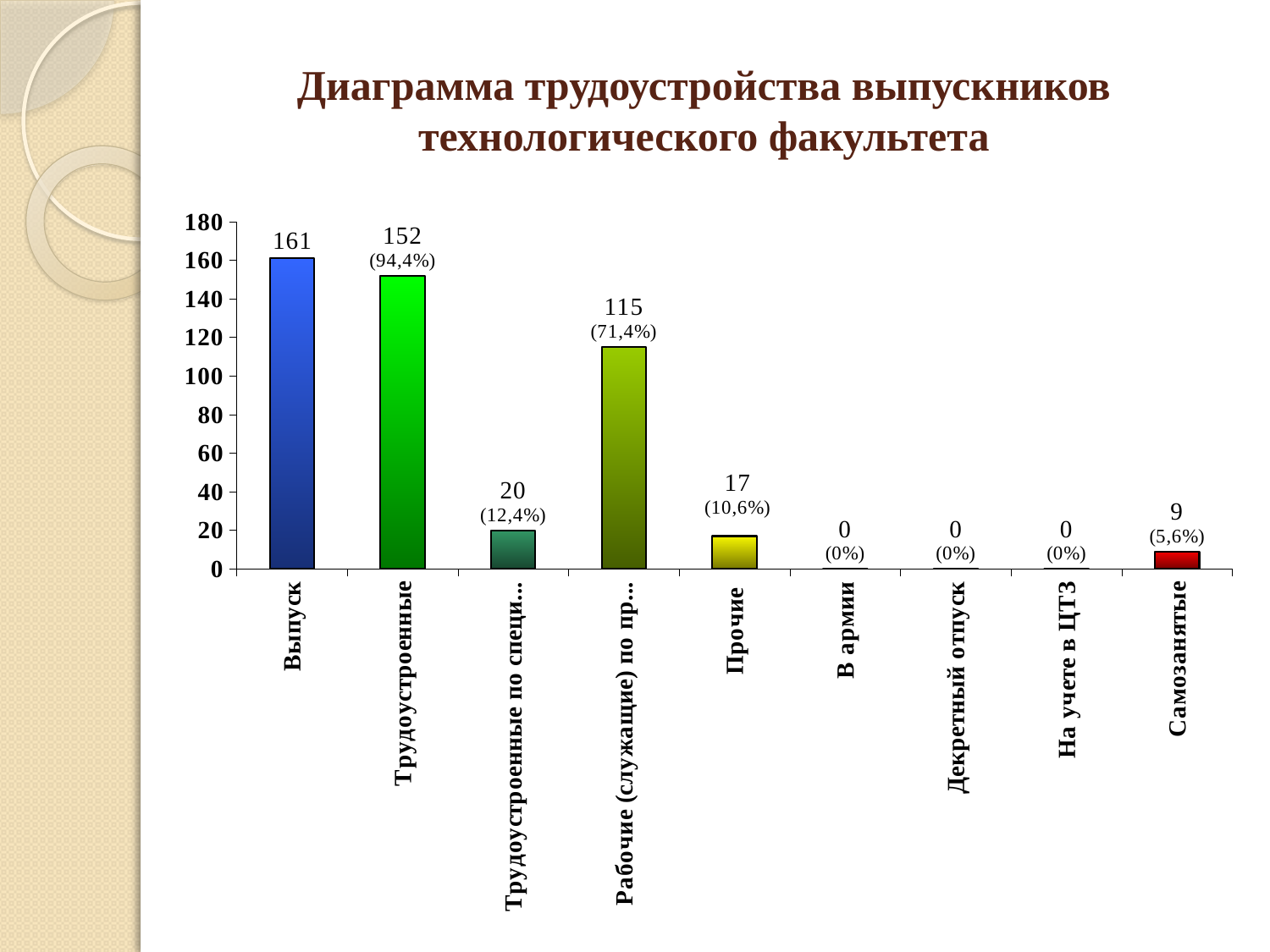
What is the value for Трудоустроенные? 152 What is the value for Выпуск? 161 How many categories have a value of 0? 3 How many categories are shown on the x axis? 9 What is the difference between the values for Выпуск and Трудоустроенные? 9 What is the value for Самозанятые? 9 What kind of chart is shown on the slide? Bar chart What percentage is shown for Самозанятые? 5,6% What is the value for Прочие? 17 Which is larger, the value for Прочие or the value for Самозанятые? Прочие What percentage is shown for Трудоустроенные? 94,4% Which category has the highest value? Выпуск